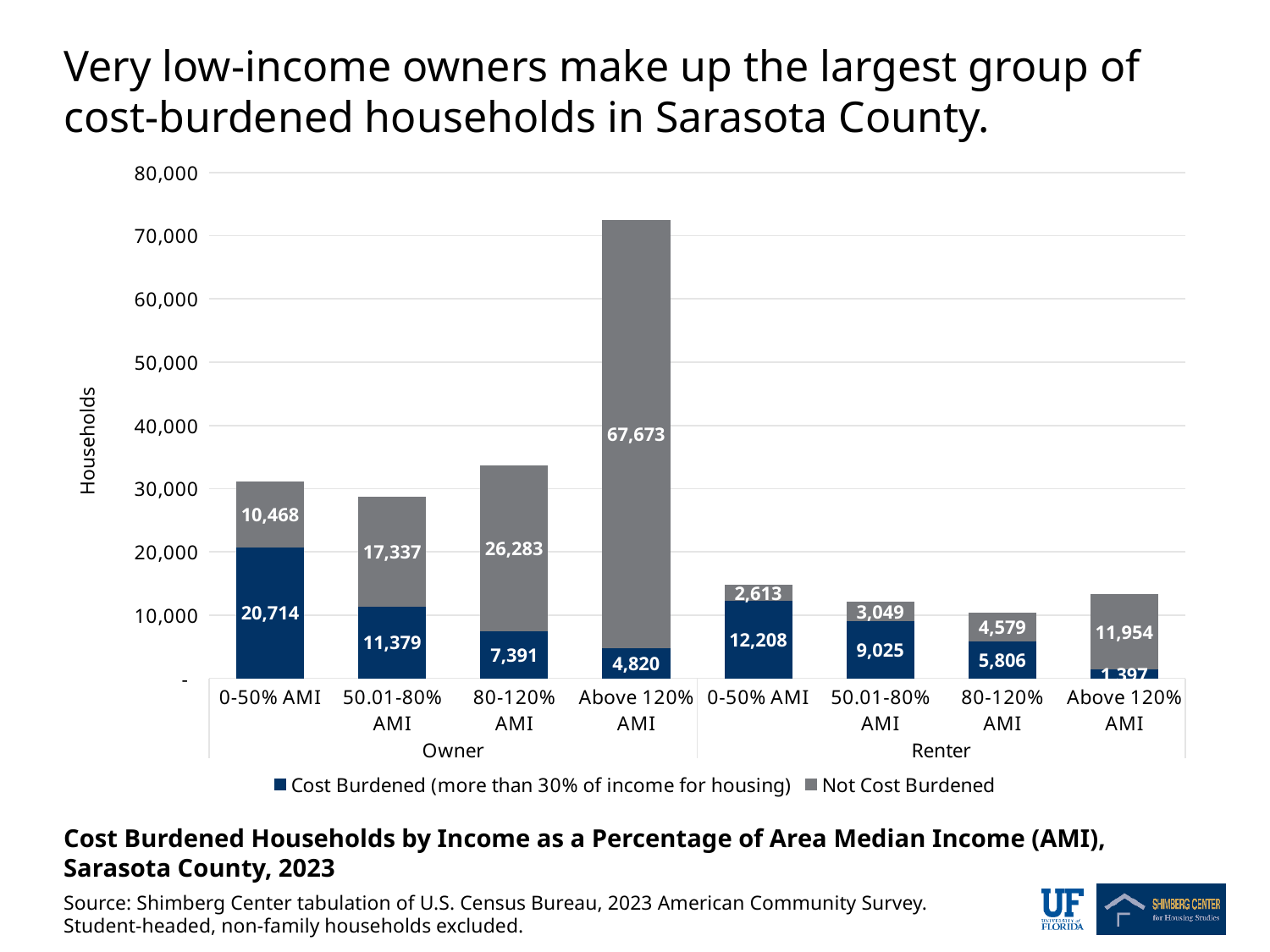
What is the total height of the stacked bar for Owner 80-120% AMI? 33,674 Which category has the highest Cost Burdened value? Owner 0-50% AMI What type of chart is shown on the slide? Stacked bar chart Is the total for the Owner Above 120% AMI bar greater or less than 70,000? greater What is the difference between the Cost Burdened values for Owner 0-50% AMI and Renter 0-50% AMI? 8,506 What is the Not Cost Burdened value for Renter households at 80-120% AMI? 4,579 How many series does the legend list? 2 What is the Cost Burdened value for Renter households at 50.01-80% AMI? 9,025 Which is larger: the Cost Burdened value for Owner 50.01-80% AMI or the Not Cost Burdened value for Owner 50.01-80% AMI? Not Cost Burdened (17,337) What is the Not Cost Burdened value for Owner households Above 120% AMI? 67,673 What is the Cost Burdened value for Owner households at 0-50% AMI? 20,714 Which category has the largest Not Cost Burdened value? Owner Above 120% AMI